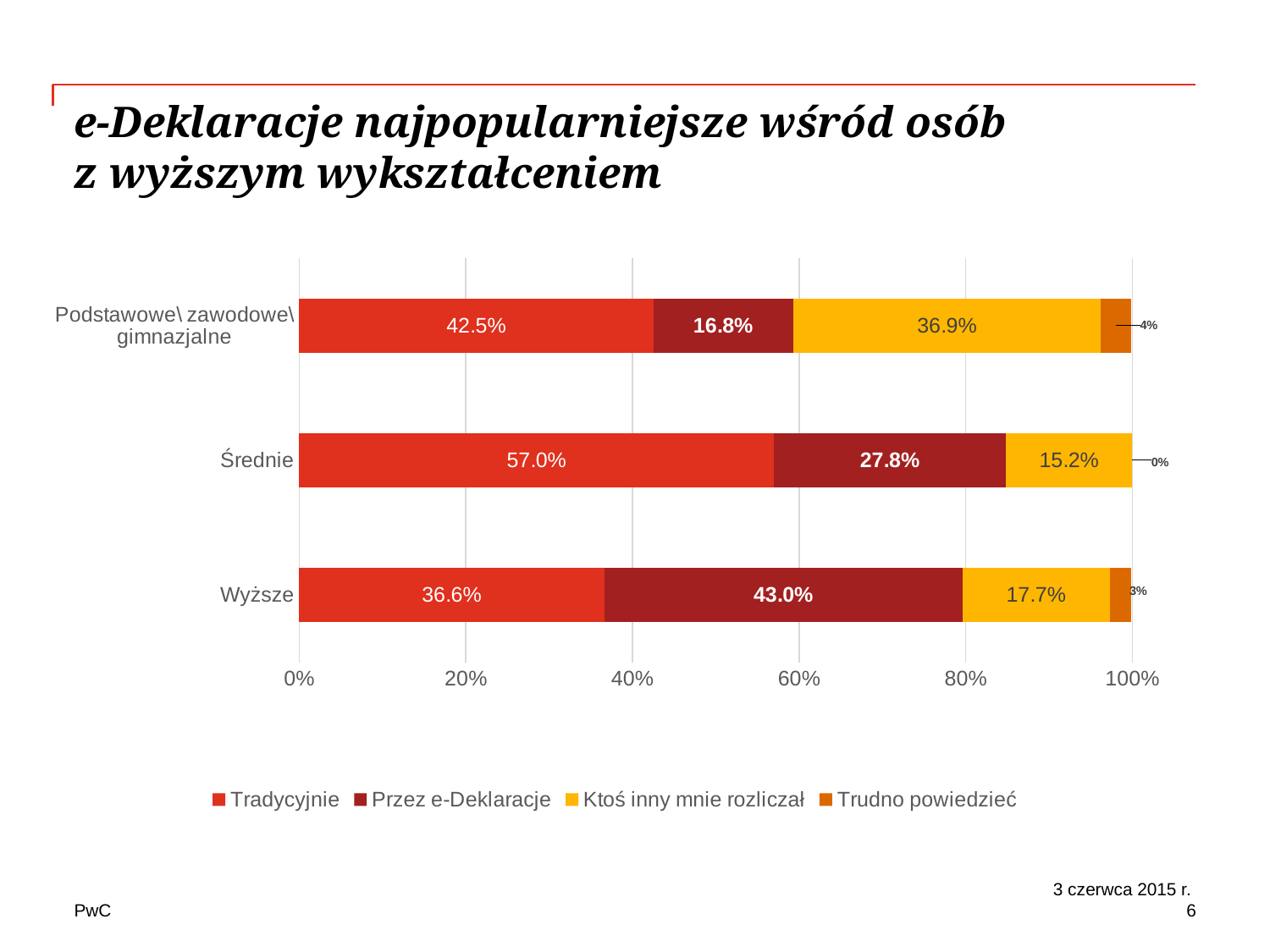
Which education category has the lowest value for 'Tradycyjnie'? Wyższe How many series does the legend list? 4 How many education categories are shown on the chart? 3 Which education category has the highest value for 'Przez e-Deklaracje'? Wyższe Is the 'Tradycyjnie' value for 'Średnie' greater or less than 40%? greater Which is larger: the 'Tradycyjnie' value for 'Podstawowe\ zawodowe\ gimnazjalne' or for 'Średnie'? Średnie What is the difference between the 'Przez e-Deklaracje' values for 'Wyższe' and 'Średnie'? 15.2% What type of chart is shown on the slide? stacked bar chart What is the value of 'Przez e-Deklaracje' for the 'Wyższe' category? 43.0% Which legend entry is shown in yellow? Ktoś inny mnie rozliczał What is the value of 'Tradycyjnie' for the 'Średnie' category? 57.0% What is the value of 'Ktoś inny mnie rozliczał' for the 'Podstawowe\ zawodowe\ gimnazjalne' category? 36.9%